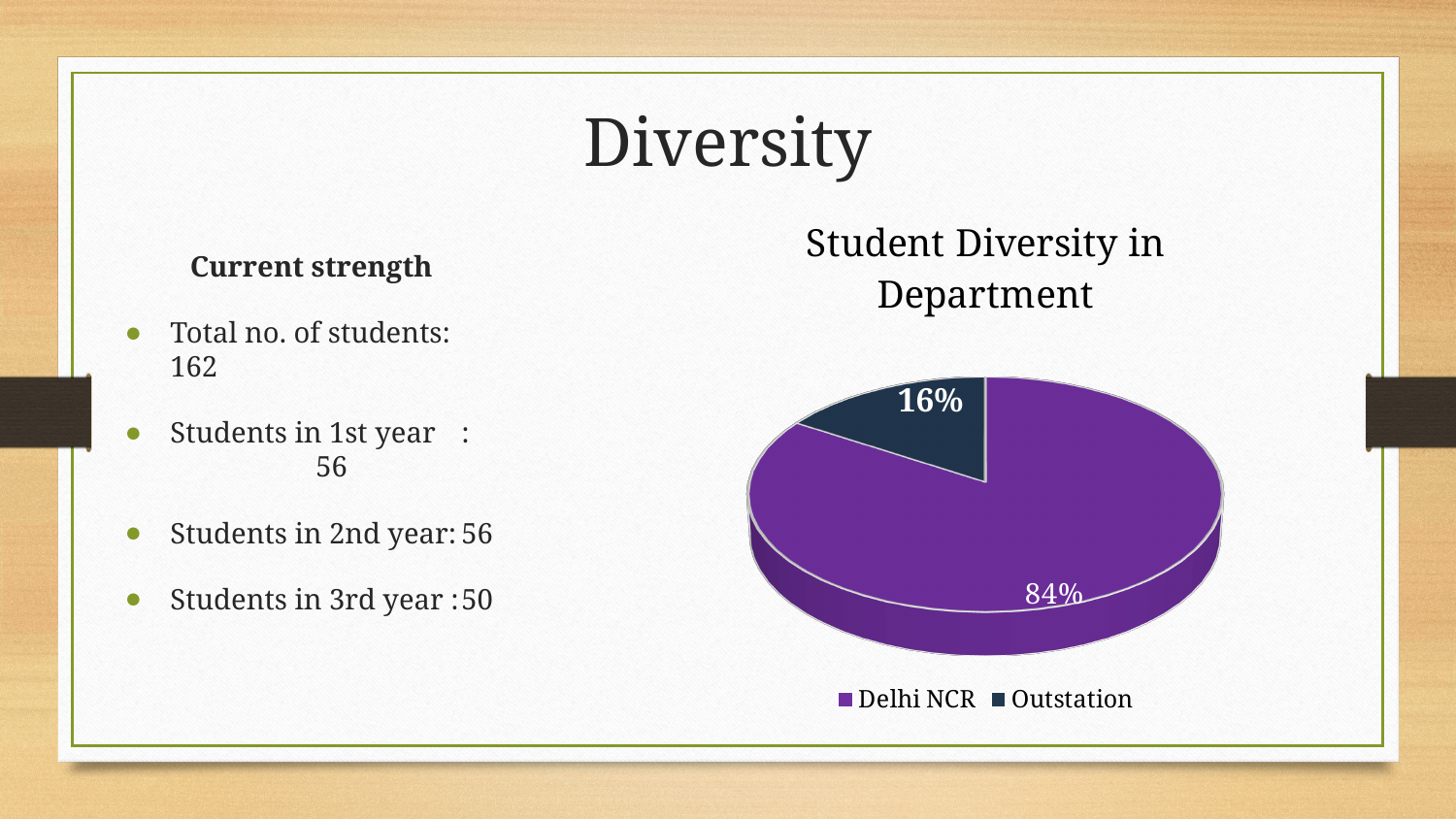
What colour is the Outstation slice? dark navy blue How many categories does the pie chart show? 2 What is the difference in percentage points between the Delhi NCR and Outstation slices? 68 Which slice is larger, Delhi NCR or Outstation? Delhi NCR Which category has the largest slice of the pie? Delhi NCR What share of the pie does Delhi NCR represent? 84% What is the title of the chart? Student Diversity in Department What share of the pie does Outstation represent? 16% Which category has the smallest slice of the pie? Outstation How many entries does the legend list? 2 What kind of chart is shown on the slide? pie chart